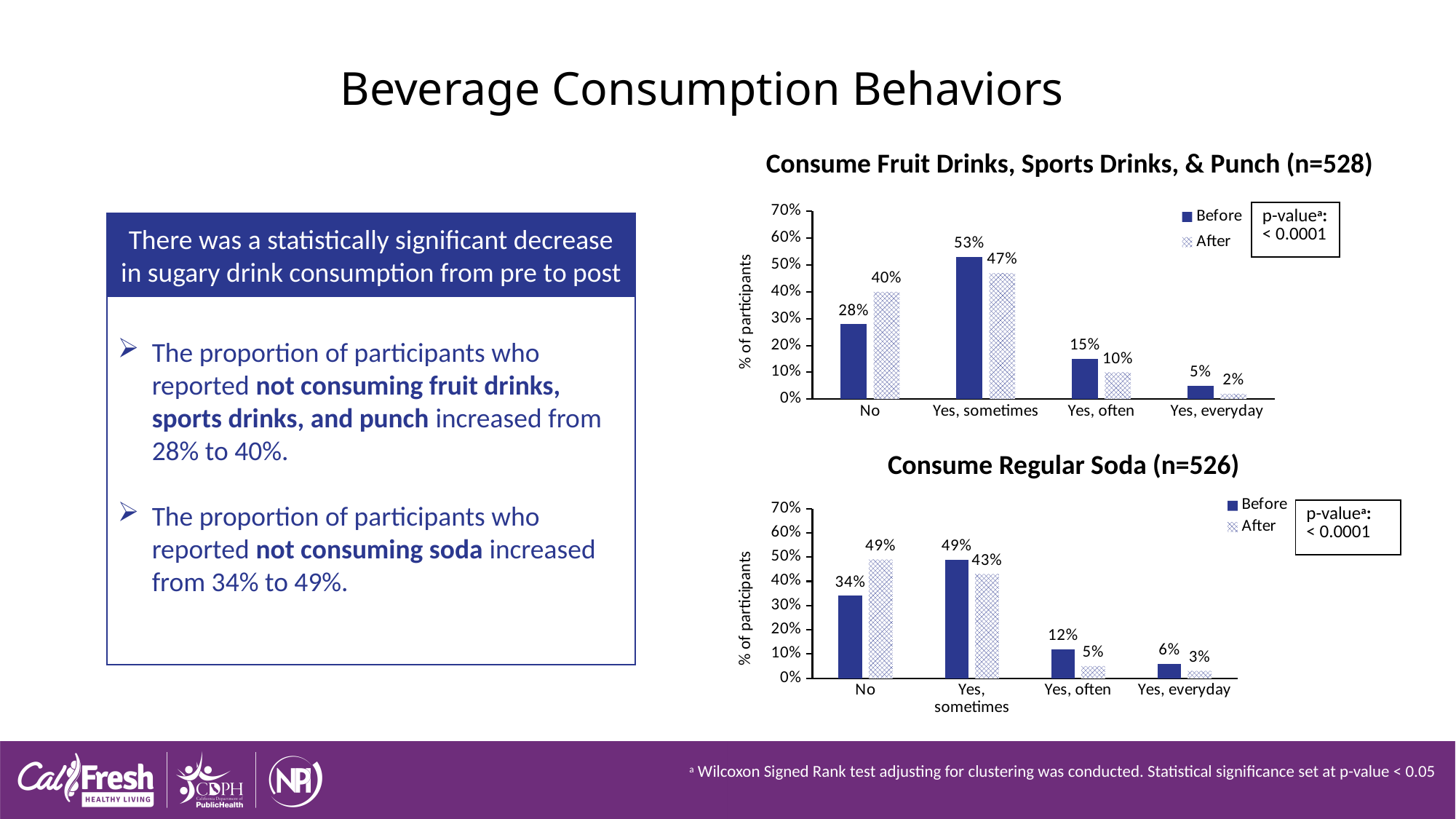
In the 'Consume Regular Soda (n=526)' chart, which category has the highest Before value? Yes, sometimes In the 'Consume Regular Soda (n=526)' chart, which is larger for 'Yes, sometimes': the Before value or the After value? Before In the 'Consume Fruit Drinks, Sports Drinks, & Punch (n=528)' chart, what is the Before value for 'Yes, sometimes'? 53% In the 'Consume Regular Soda (n=526)' chart, what is the After value for 'Yes, everyday'? 3% In the 'Consume Regular Soda (n=526)' chart, what is the difference between the After and Before values for 'No'? 15% In the 'Consume Fruit Drinks, Sports Drinks, & Punch (n=528)' chart, what is the difference between the Before and After values for 'Yes, often'? 5% What kind of chart is the 'Consume Regular Soda (n=526)' chart? Bar chart In the 'Consume Fruit Drinks, Sports Drinks, & Punch (n=528)' chart, which category has the lowest After value? Yes, everyday How many categories are shown on the x axis of the 'Consume Fruit Drinks, Sports Drinks, & Punch (n=528)' chart? 4 In the 'Consume Regular Soda (n=526)' chart, what is the Before value for 'Yes, often'? 12% In the 'Consume Fruit Drinks, Sports Drinks, & Punch (n=528)' chart, what is the After value for 'No'? 40% How many series does the legend of the 'Consume Regular Soda (n=526)' chart list? 2